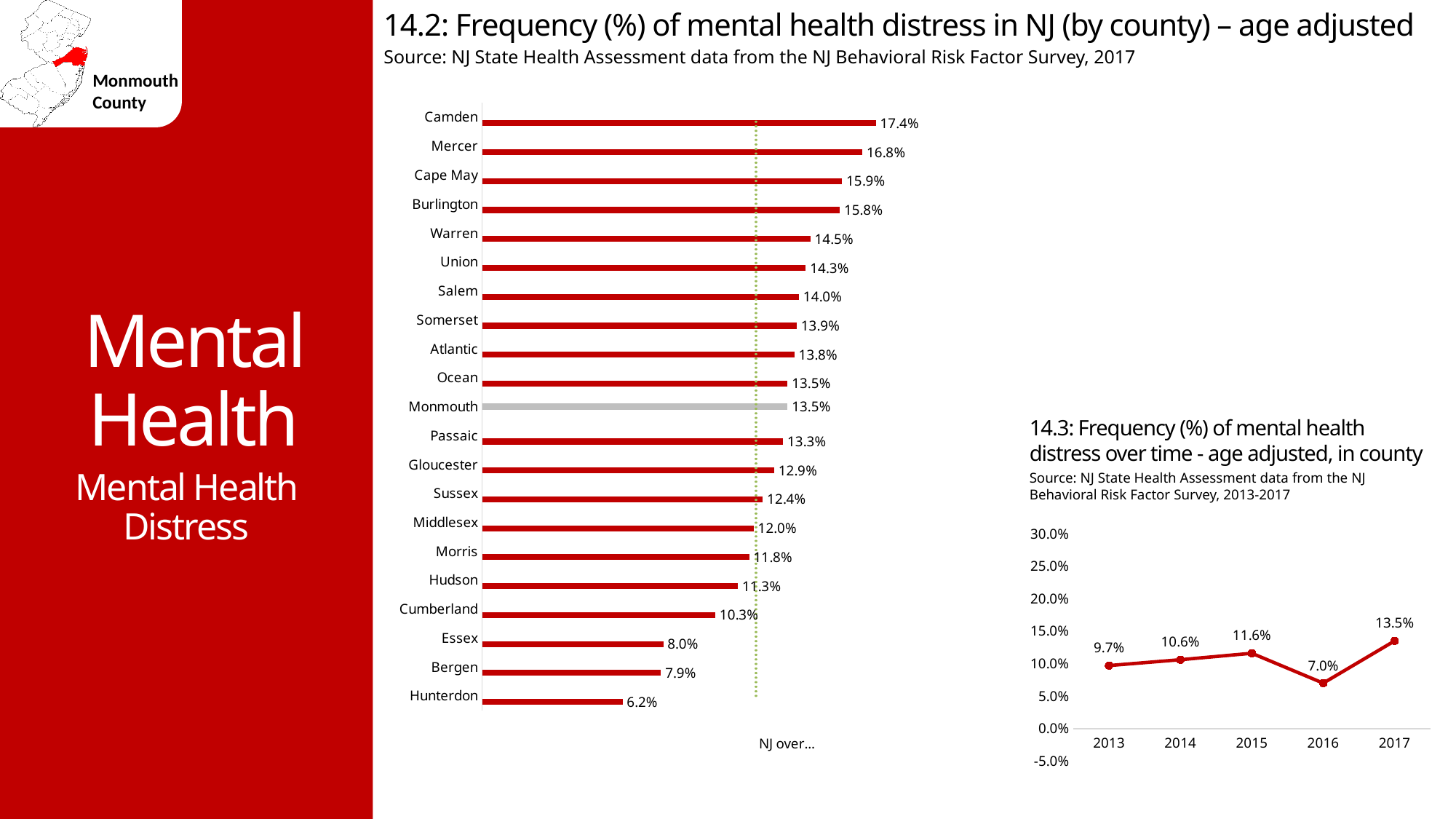
In chart 14.3 (over time), what is the value for 2016? 7.0% In chart 14.2 (by county), what is the value for Cumberland? 10.3% In chart 14.2 (by county), what is the difference between Camden and Hunterdon? 11.2% In chart 14.2 (by county), which county has the lowest value? Hunterdon In chart 14.3 (over time), which year has the highest value? 2017 What kind of chart is chart 14.3 (over time)? Line chart In chart 14.2 (by county), which is larger, the value for Essex or the value for Bergen? Essex In chart 14.2 (by county), which county has the highest value? Camden In chart 14.3 (over time), what is the difference between the 2017 and 2016 values? 6.5% In chart 14.2 (by county), what is the value for Monmouth? 13.5% In chart 14.2 (by county), how many counties are shown? 21 What kind of chart is chart 14.2 (by county)? Bar chart